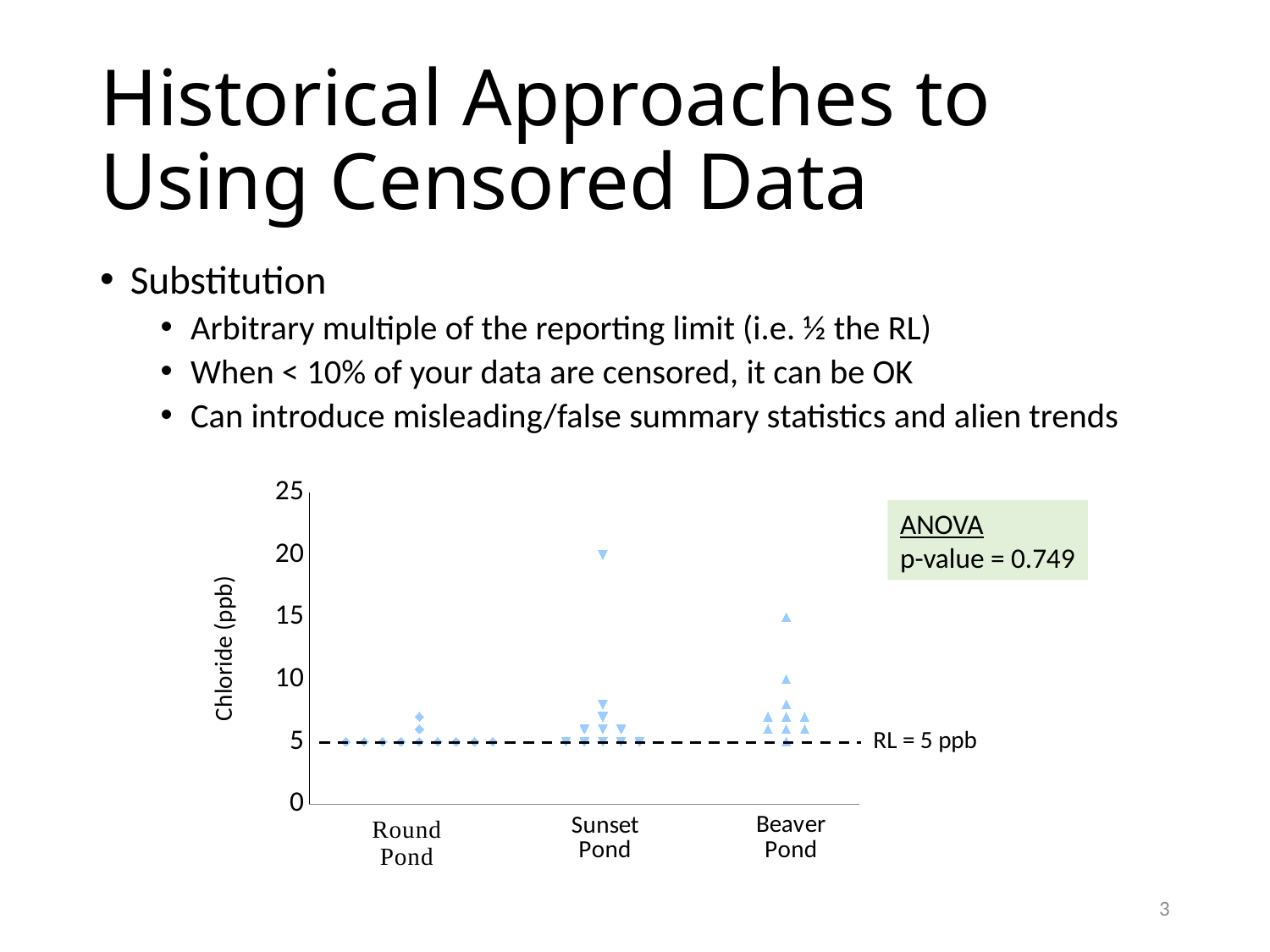
What ANOVA p-value is shown on the chart? 0.749 Which pond has the single highest chloride value on the chart? Sunset Pond What is the label of the y axis of the chart? Chloride (ppb) What kind of chart is shown on the slide? scatter plot What reporting limit (RL) is marked by the dashed line on the chart? 5 ppb How many ponds are plotted along the x axis of the chart? 3 Which pond has the fewest points above the RL = 5 ppb line? Round Pond Which is larger, the highest value for Round Pond or the highest value for Beaver Pond? Beaver Pond Is the highest value for Round Pond greater or less than 10? less Is the highest value for Beaver Pond greater or less than 10? greater Is the highest value for Sunset Pond greater or less than 15? greater What is the highest tick value shown on the y axis of the chart? 25